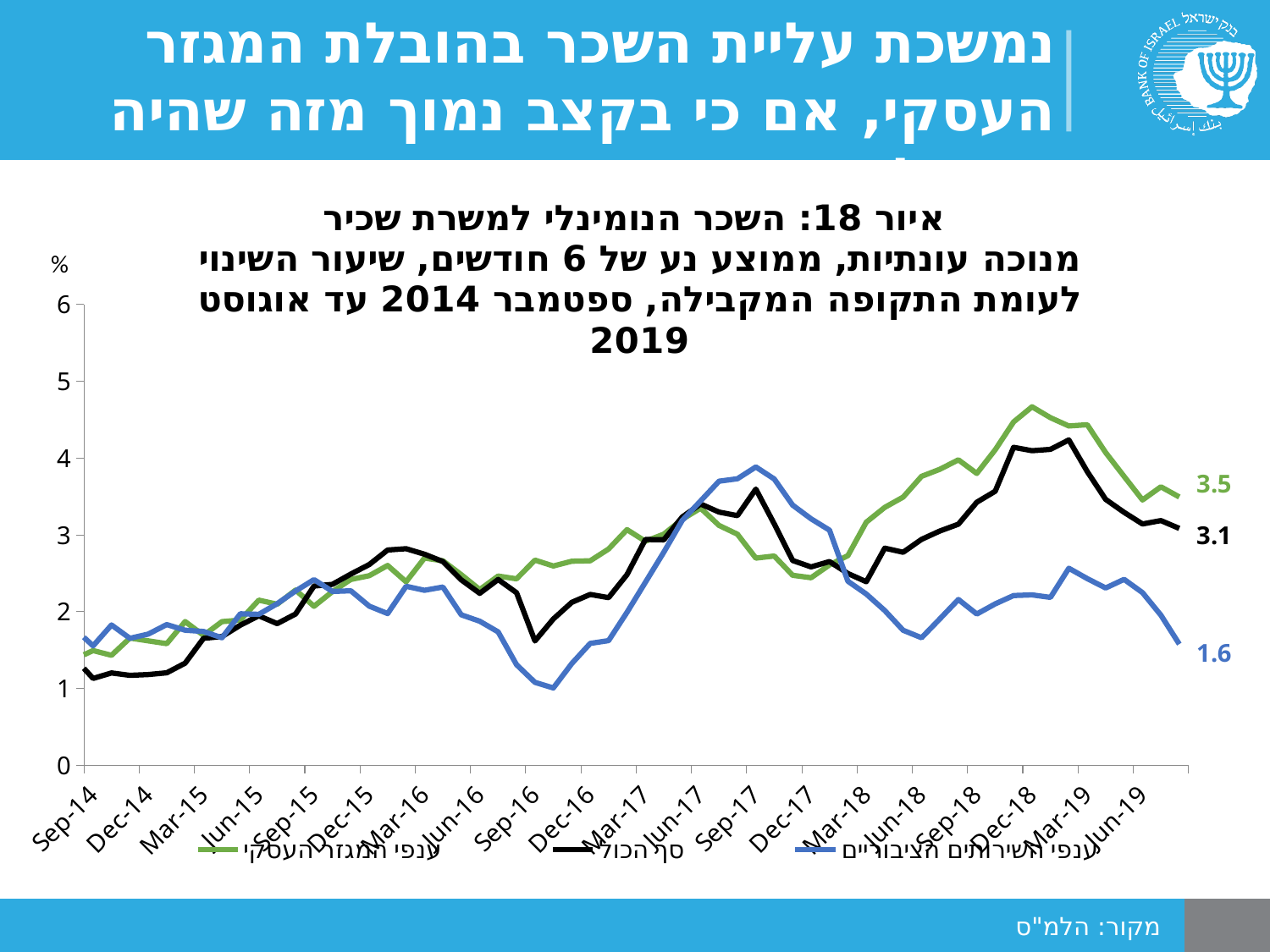
What is the final labelled value of the black series (סך הכול)? 3.1 What is the difference between the final labelled values of the green series (3.5) and the blue series (1.6)? 1.9 Which series has the highest final labelled value? ענפי המגזר העסקי (green) What is the final labelled value of the blue series (ענפי השירותים הציבוריים)? 1.6 How many series does the legend list? 3 What is the final labelled value of the green series (ענפי המגזר העסקי)? 3.5 What kind of chart is shown on the slide? line chart Which series has the lowest final labelled value? ענפי השירותים הציבוריים (blue) Is the value of the blue series at Sep-16 greater or less than 2? less Is the value of the green series at Dec-18 greater or less than 4? greater What unit is shown on the y axis? % What is the difference between the final labelled values of the green series (3.5) and the black series (3.1)? 0.4